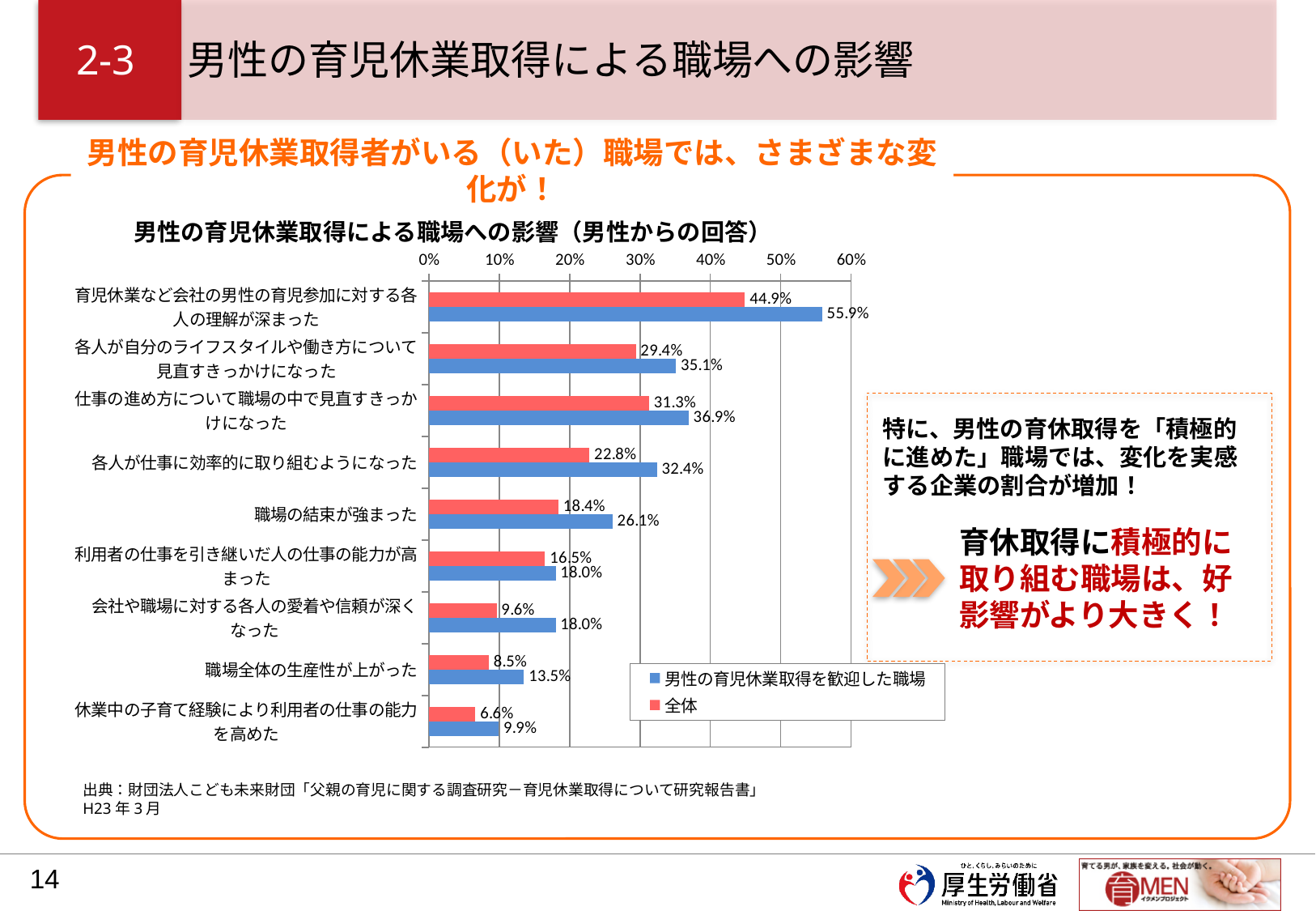
What is the value for 全体 for 「育児休業など会社の男性の育児参加に対する各人の理解が深まった」? 44.9% How many series does the legend list? 2 How many categories are plotted on the chart? 9 What is the difference between 男性の育児休業取得を歓迎した職場 and 全体 for 「各人が仕事に効率的に取り組むようになった」? 9.6% For 「会社や職場に対する各人の愛着や信頼が深くなった」, which series has the larger value, 男性の育児休業取得を歓迎した職場 or 全体? 男性の育児休業取得を歓迎した職場 What colour are the bars for the 全体 series? Red What type of chart is shown on the slide? Bar chart What is the value for 男性の育児休業取得を歓迎した職場 for 「職場の結束が強まった」? 26.1% Which category has the lowest value for 全体? 休業中の子育て経験により利用者の仕事の能力を高めた What is the value for 全体 for 「職場全体の生産性が上がった」? 8.5% Is the value for 全体 for 「仕事の進め方について職場の中で見直すきっかけになった」 greater or less than 30%? greater Which category has the highest value for 男性の育児休業取得を歓迎した職場? 育児休業など会社の男性の育児参加に対する各人の理解が深まった